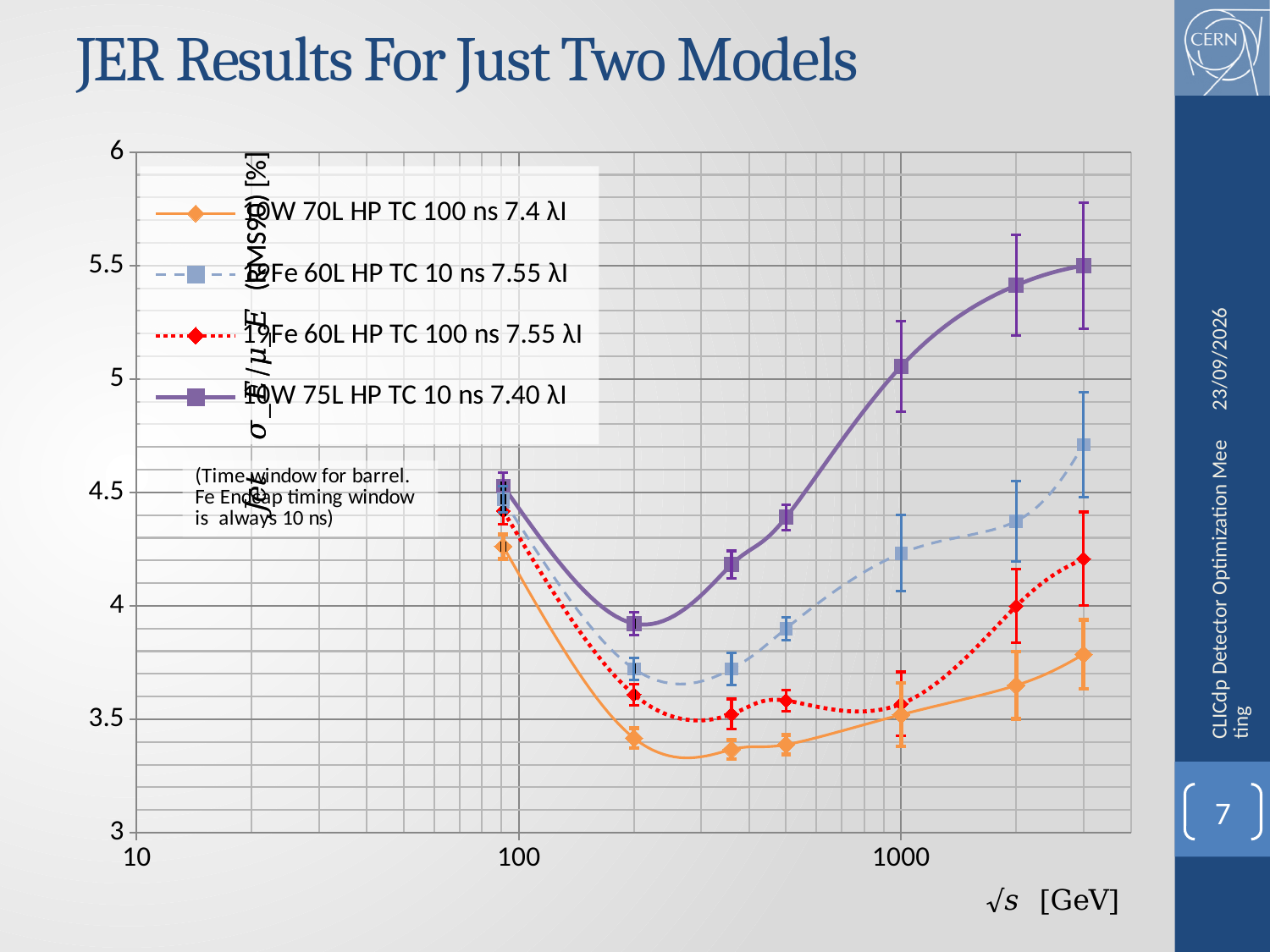
What is the label of the x axis? √s [GeV] How many series does the legend list? 4 Which series has the highest value at 3000 GeV? W 75L HP TC 10 ns 7.40 λI (purple solid) Is the value of the purple solid series (W 75L HP TC 10 ns 7.40 λI) at 200 GeV greater or less than 4? less What kind of chart is shown on the slide? line chart Is the value of the purple solid series (W 75L HP TC 10 ns 7.40 λI) at 3000 GeV greater or less than 5? greater What is the title of the chart on the slide? JER Results For Just Two Models Which series has the lowest value at 200 GeV? W 70L HP TC 100 ns 7.4 λI (orange) Is the value of the light blue dashed series (Fe 60L HP TC 10 ns 7.55 λI) at 3000 GeV greater or less than 4.5? greater Does the purple solid series (W 75L HP TC 10 ns 7.40 λI) rise or fall between 200 GeV and 3000 GeV? rise At 200 GeV, which is larger: the red dotted series (Fe 60L HP TC 100 ns 7.55 λI) or the orange series (W 70L HP TC 100 ns 7.4 λI)? the red dotted series